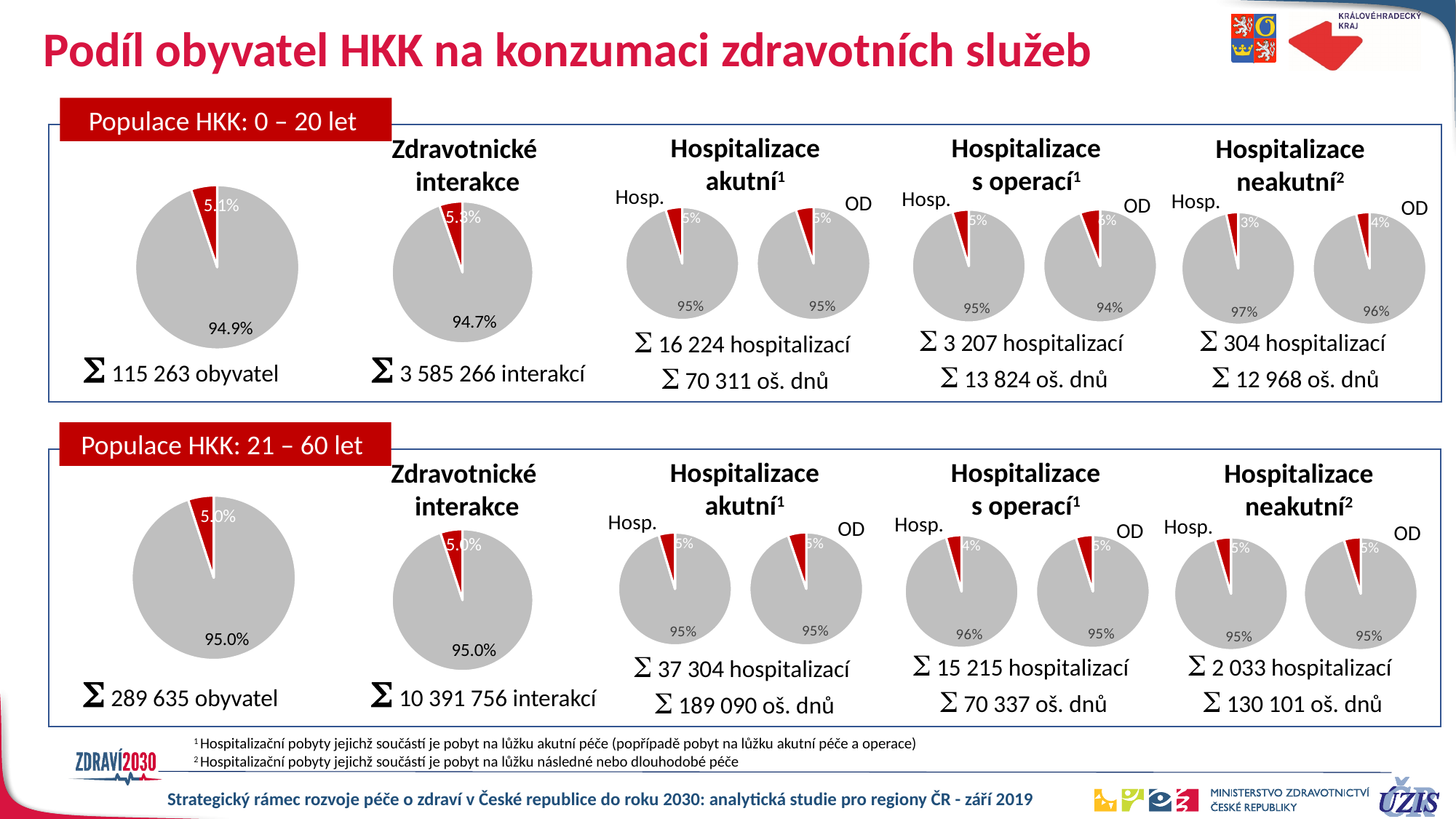
In the 'Populace HKK: 21 – 60 let' section, what share of the first pie chart (obyvatel) is shown by the grey slice? 95.0% In the 'Populace HKK: 0 – 20 let' section, what share of the 'Zdravotnické interakce' pie chart is shown by the grey slice? 94.7% In the 'Populace HKK: 0 – 20 let' section, which is larger: the grey slice of the 'Hosp.' pie under 'Hospitalizace neakutní' (97%) or the grey slice of the 'OD' pie under 'Hospitalizace s operací' (94%)? Hosp. pie under Hospitalizace neakutní (97%) In the 'Populace HKK: 0 – 20 let' section, what share of the first pie chart (obyvatel) is shown by the grey slice? 94.9% In the 'Populace HKK: 0 – 20 let' section, what percentage is labelled on the grey slice of the 'Hosp.' pie under 'Hospitalizace neakutní'? 97% What type of charts are used on this slide? Pie charts How many slices does each pie chart on the slide have? 2 In the 'Populace HKK: 0 – 20 let' section, what percentage is labelled on the grey slice of the 'OD' pie under 'Hospitalizace s operací'? 94% In the 'Populace HKK: 21 – 60 let' section, what percentage is labelled on the grey slice of the 'Hosp.' pie under 'Hospitalizace s operací'? 96% What colour is used for the smaller slice in every pie chart on the slide? Red What total number of hospitalizations is shown under 'Hospitalizace akutní' in the 'Populace HKK: 21 – 60 let' section? 37 304 hospitalizací In the 'Populace HKK: 0 – 20 let' section, what is the difference between the grey slice of the first pie (94.9%) and the grey slice of the 'Zdravotnické interakce' pie (94.7%)? 0.2%